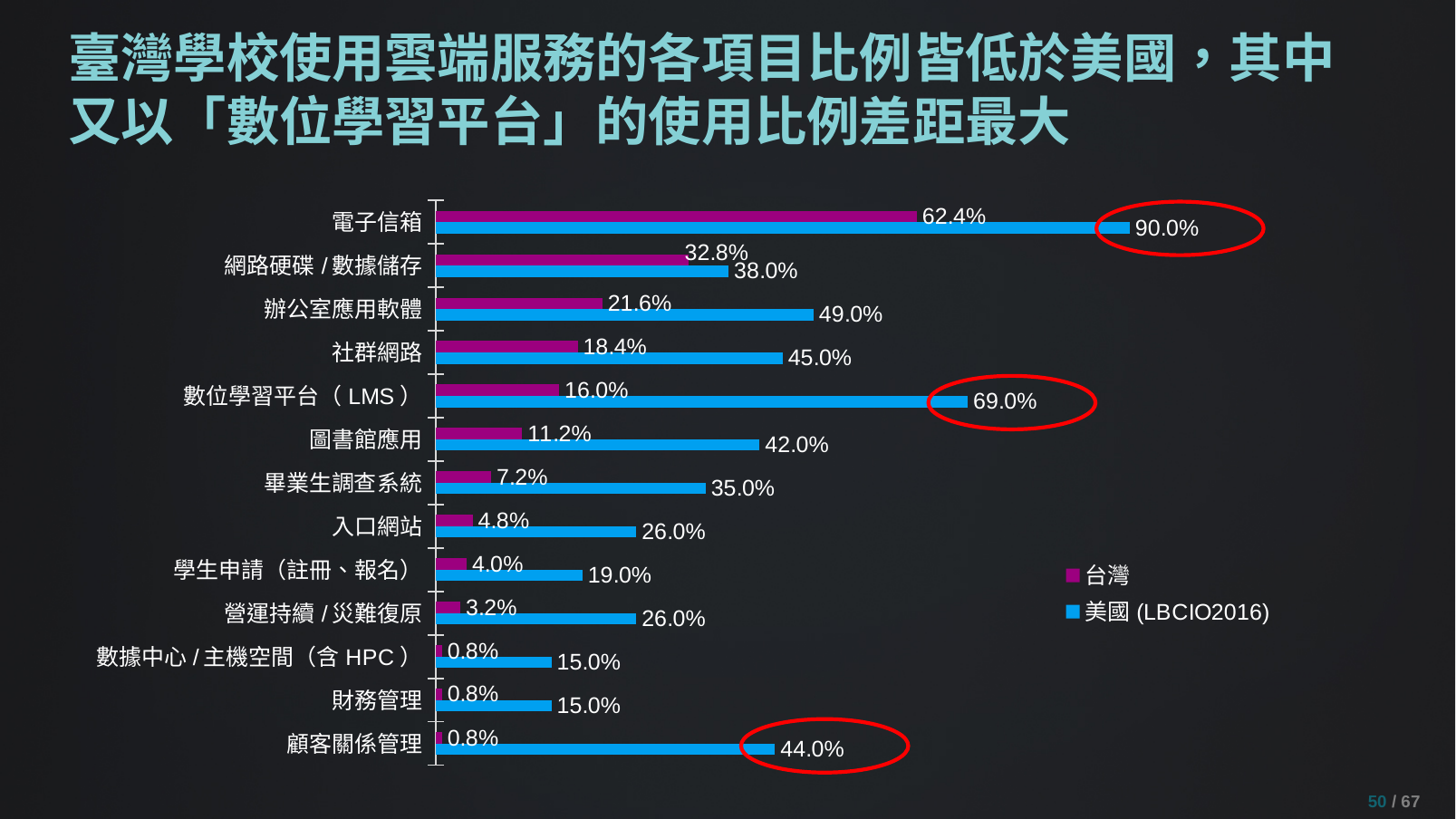
How many series does the legend list? 2 Which colour represents the 台灣 series in the chart? Purple What kind of chart is shown on the slide? Bar chart What is the difference between the 美國 (LBCIO2016) and 台灣 values for 數位學習平台（LMS）? 53.0% What is the value for 台灣 in the 電子信箱 category? 62.4% What is the difference between the 美國 (LBCIO2016) and 台灣 values for 電子信箱? 27.6% Which is larger: the 台灣 value for 網路硬碟 / 數據儲存 or the 台灣 value for 辦公室應用軟體? 網路硬碟 / 數據儲存 How many categories are shown in the chart? 13 What is the value for 美國 (LBCIO2016) in the 數位學習平台（LMS） category? 69.0% What is the value for 美國 (LBCIO2016) in the 顧客關係管理 category? 44.0% Which category has the lowest value for 美國 (LBCIO2016)? 數據中心 / 主機空間（含 HPC） and 財務管理 (both 15.0%) Which category has the highest value for 美國 (LBCIO2016)? 電子信箱